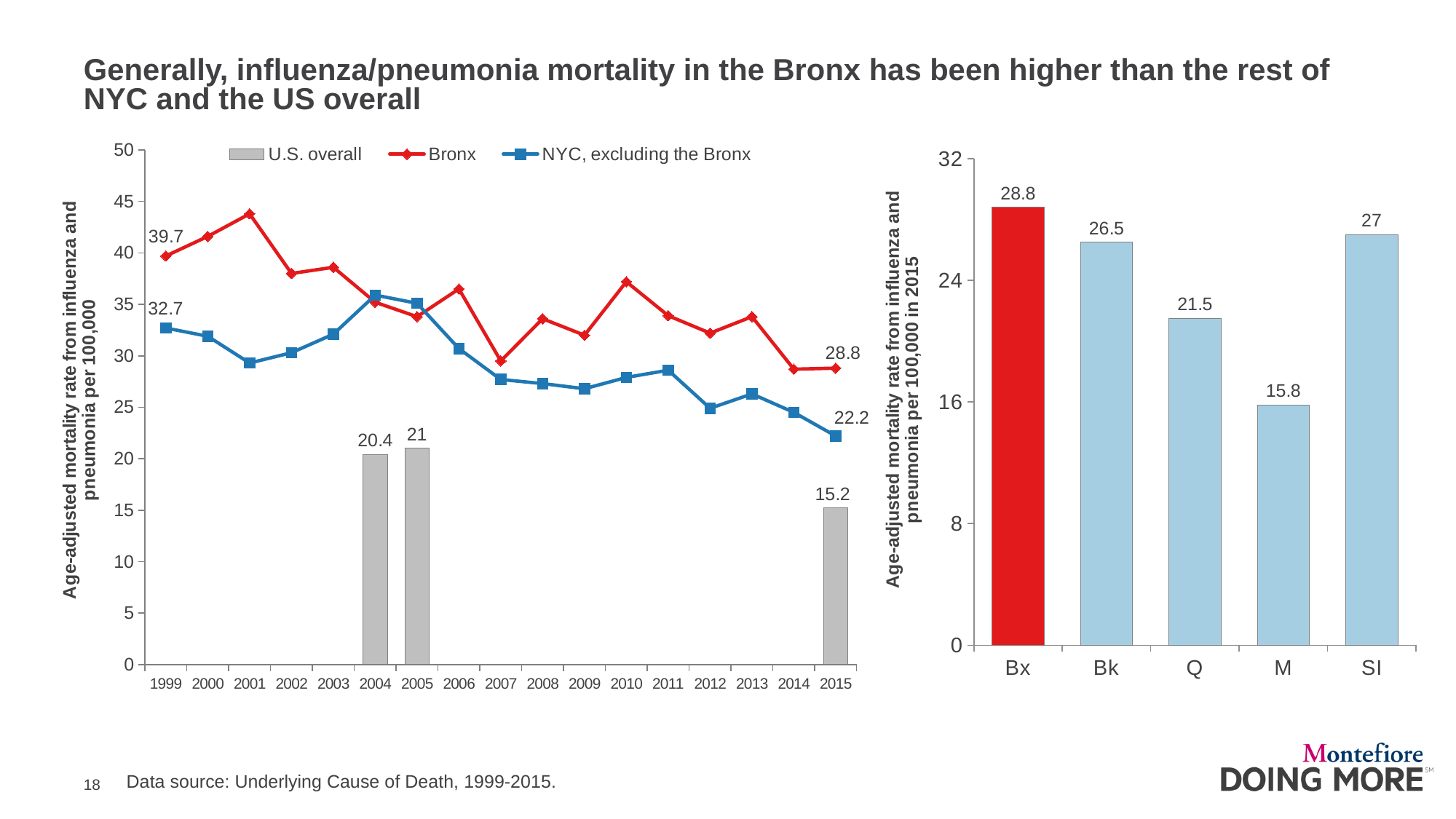
In the left-hand chart, is the Bronx value in 2001 greater or less than 40? greater In the left-hand chart, how many series does the legend list? 3 In the left-hand chart, what is the value for NYC, excluding the Bronx in 2015? 22.2 In the right-hand bar chart, what is the value for Bx? 28.8 In the left-hand chart, does the Bronx line generally rise or fall from 1999 to 2015? fall In the right-hand bar chart, which borough has the lowest value? M In the right-hand bar chart, what is the value for M? 15.8 In the right-hand bar chart, which borough has the highest value? Bx In the left-hand chart, what is the U.S. overall value in 2005? 21 In the left-hand chart, what is the Bronx value in 1999? 39.7 In the right-hand bar chart, how many boroughs are shown? 5 In the right-hand bar chart, what is the difference between the values for Bx and Bk? 2.3